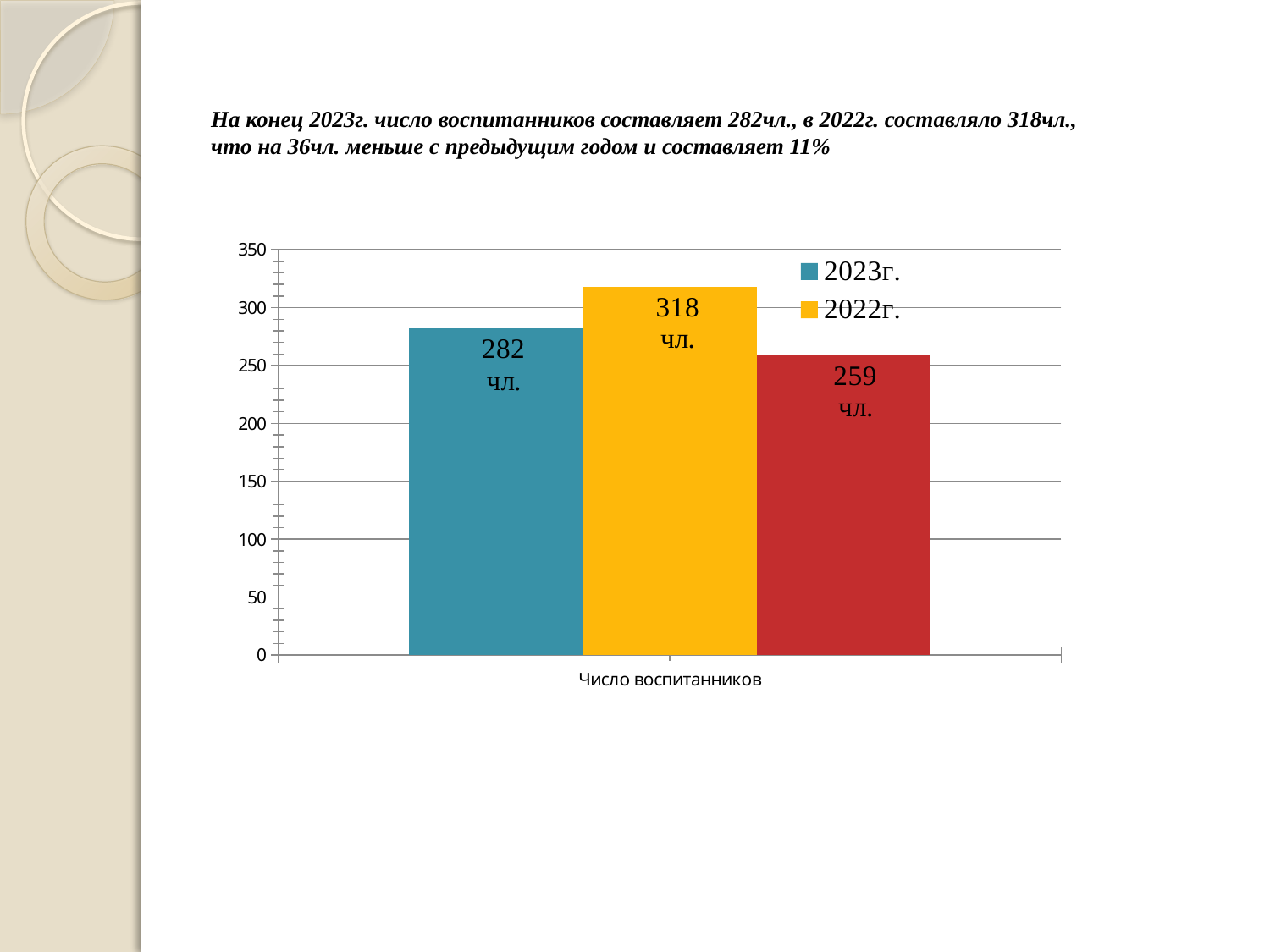
What is the value shown for 2022г. in the chart? 318 чл. What value is printed on the red bar in the chart? 259 чл. What is the value shown for 2023г. in the chart? 282 чл. Which legend series has the highest bar in the chart? 2022г. How many bars are plotted in the chart? 3 Is the value for 2023г. greater or less than 250? greater What is the value of the lowest bar in the chart? 259 чл. What type of chart is shown on the slide? bar chart What is the difference between the 2023г. bar and the red bar? 23 How many series does the chart legend list? 2 Which is larger, the value for 2023г. or the value for 2022г.? 2022г. By how many people does the 2022г. value exceed the 2023г. value? 36